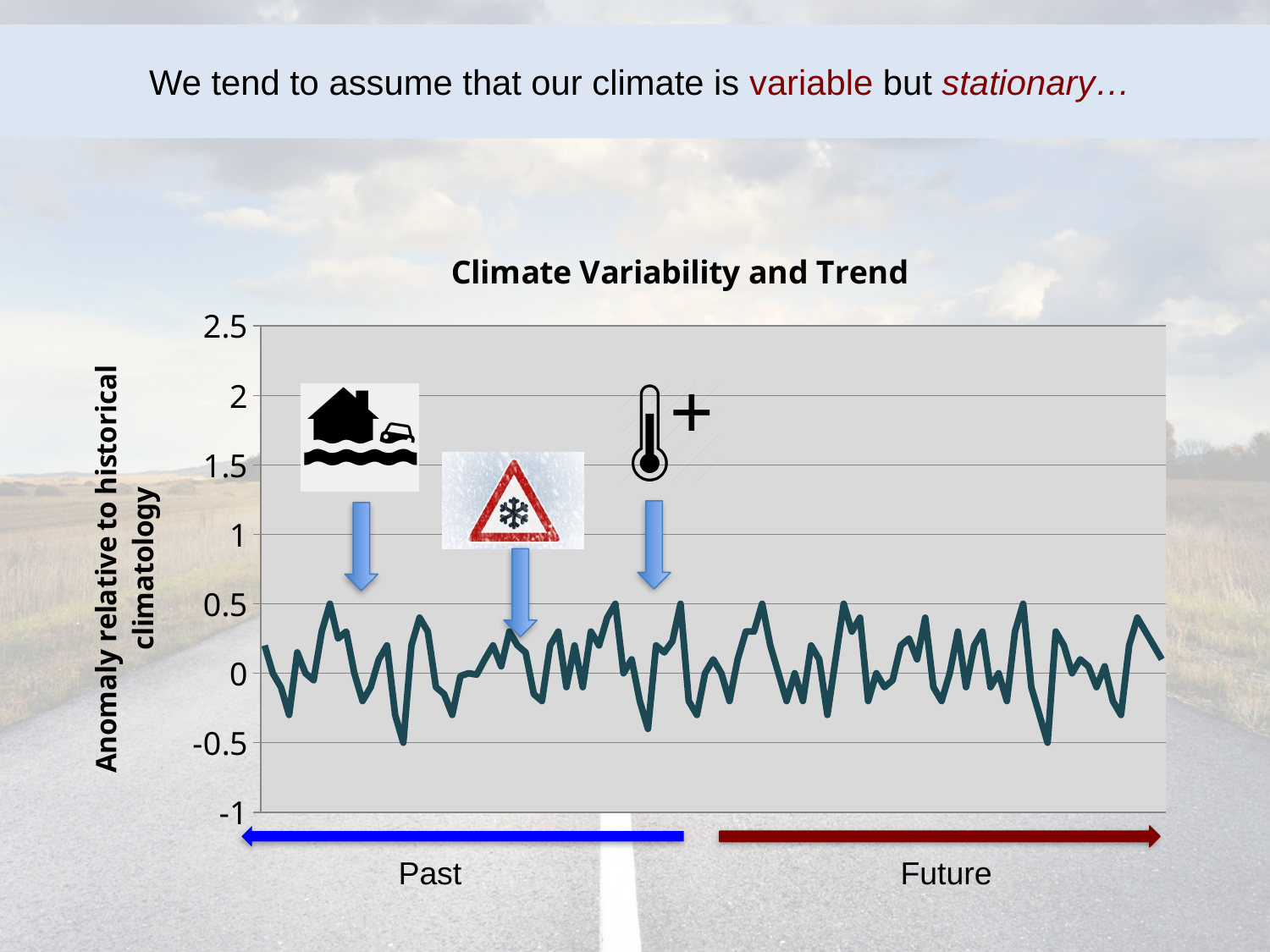
What kind of chart is shown on the slide? line chart Does the plotted line ever rise above 1 on the vertical axis? no What is the label on the vertical axis of the chart? Anomaly relative to historical climatology Does the plotted line show an overall rising trend, a falling trend, or no clear trend along the x axis? no clear trend What is the highest tick value shown on the vertical axis? 2.5 How many lines are plotted on the chart? 1 What is the title of the chart? Climate Variability and Trend Is the highest value of the plotted line greater or less than 1? less Is the lowest value of the plotted line greater or less than -1? greater